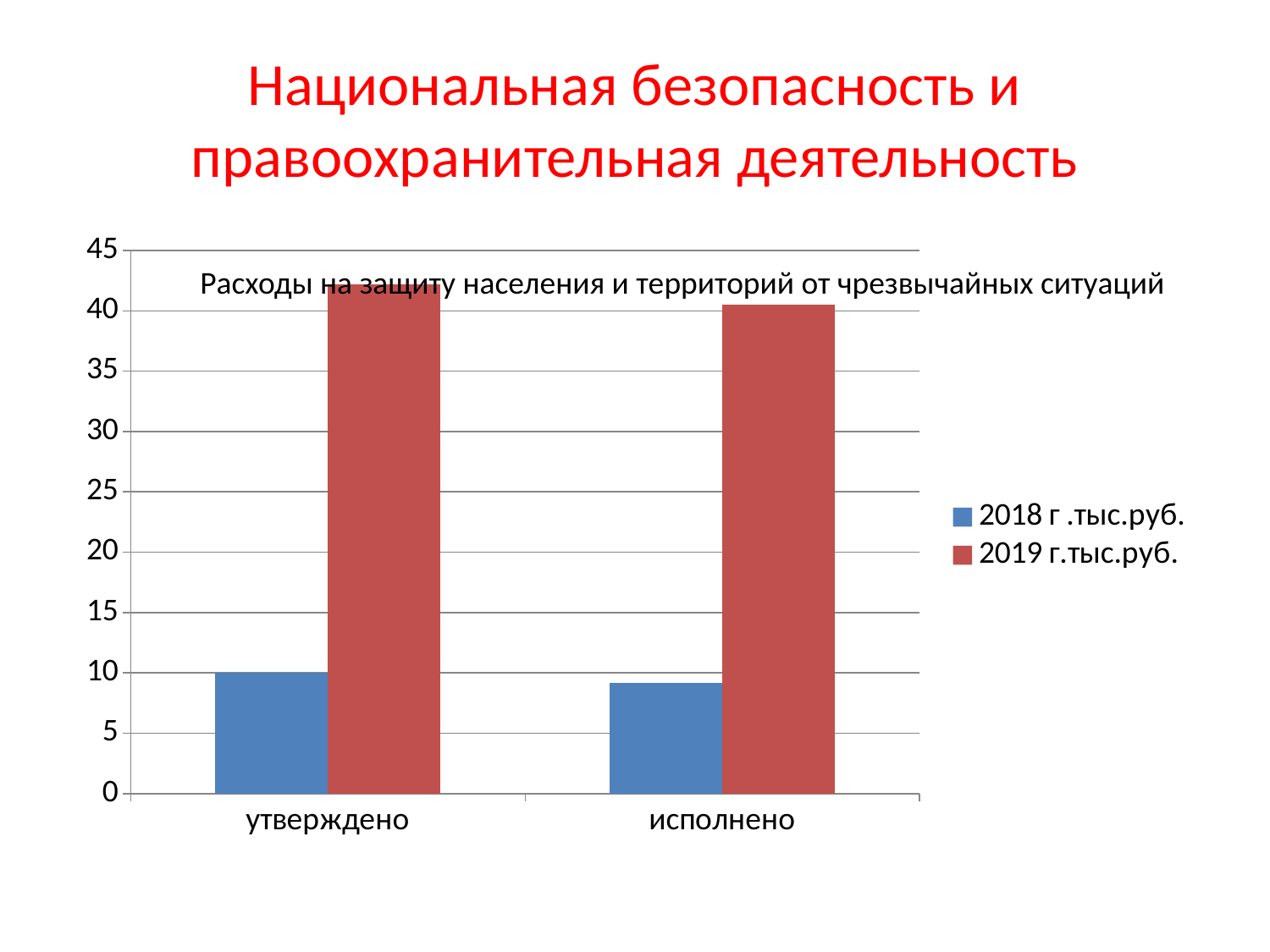
Is the value for 2018 г .тыс.руб. in the исполнено category greater or less than 10? less Is the value for 2019 г.тыс.руб. in the утверждено category greater or less than 40? greater Is the value for 2019 г.тыс.руб. in the исполнено category greater or less than 35? greater How many categories are shown on the x axis of the chart? 2 Which series is shown in red in the chart? 2019 г.тыс.руб. What kind of chart is shown on the slide? bar chart In the утверждено category, which series has the larger value, 2018 г .тыс.руб. or 2019 г.тыс.руб.? 2019 г.тыс.руб. What is the title printed inside the chart area? Расходы на защиту населения и территорий от чрезвычайных ситуаций How many series does the chart legend list? 2 For the 2018 г .тыс.руб. series, which category has the larger value, утверждено or исполнено? утверждено Which bar is the highest in the chart? 2019 г.тыс.руб., утверждено